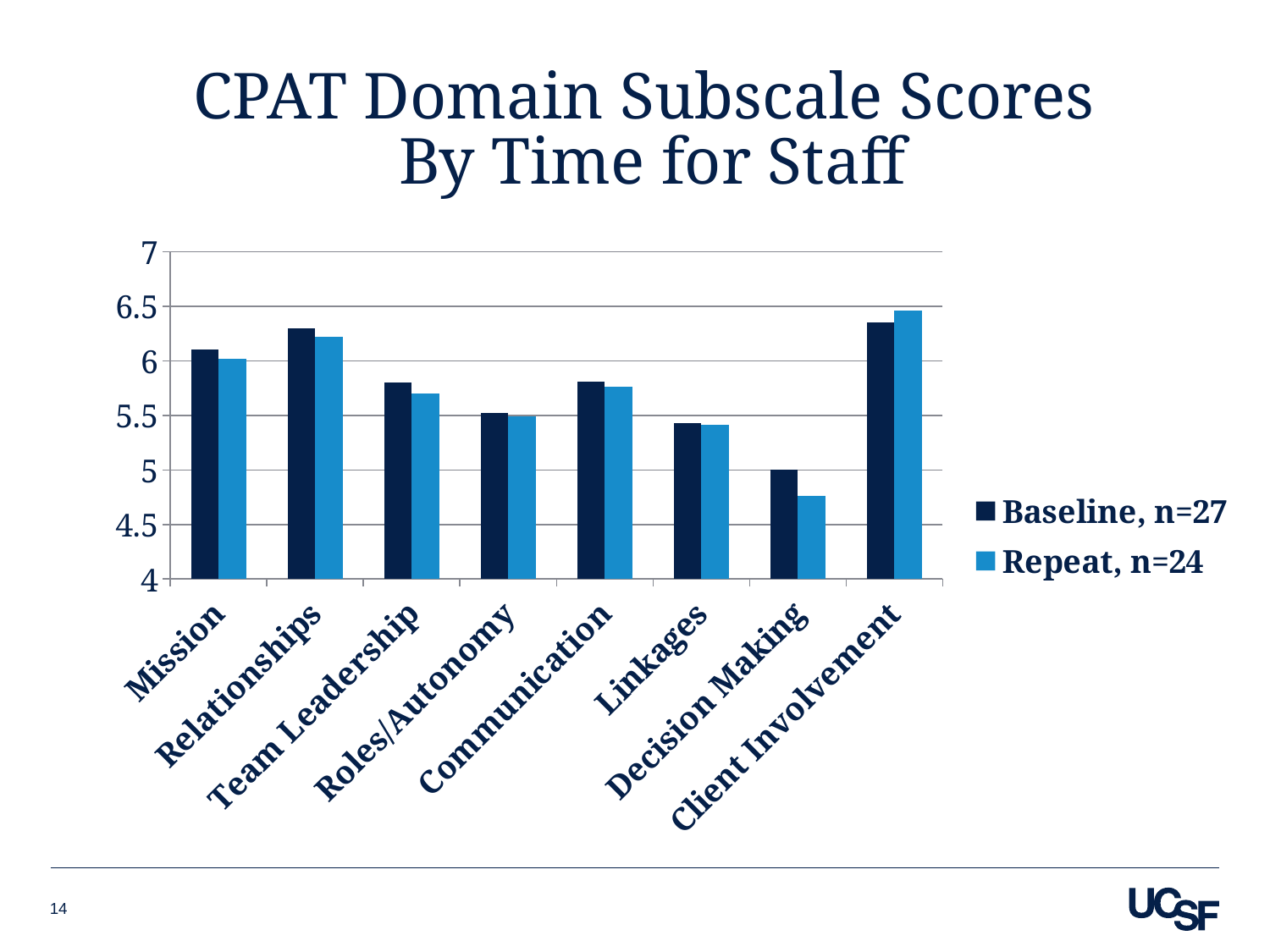
Is the Baseline, n=27 value for Linkages greater or less than 5.5? less Which domain has the lowest Baseline, n=27 score? Decision Making Which domain has the highest Repeat, n=24 score? Client Involvement What kind of chart is shown on the slide? bar chart What is the title of the chart? CPAT Domain Subscale Scores By Time for Staff How many domain categories are shown on the x axis? 8 For Decision Making, which is larger: the Baseline, n=27 value or the Repeat, n=24 value? Baseline, n=27 Which domain has the lowest Repeat, n=24 score? Decision Making Is the Baseline, n=27 value for Mission greater or less than 6? greater Is the Repeat, n=24 value for Decision Making greater or less than 5? less How many series does the legend list? 2 For Client Involvement, which is larger: the Baseline, n=27 value or the Repeat, n=24 value? Repeat, n=24